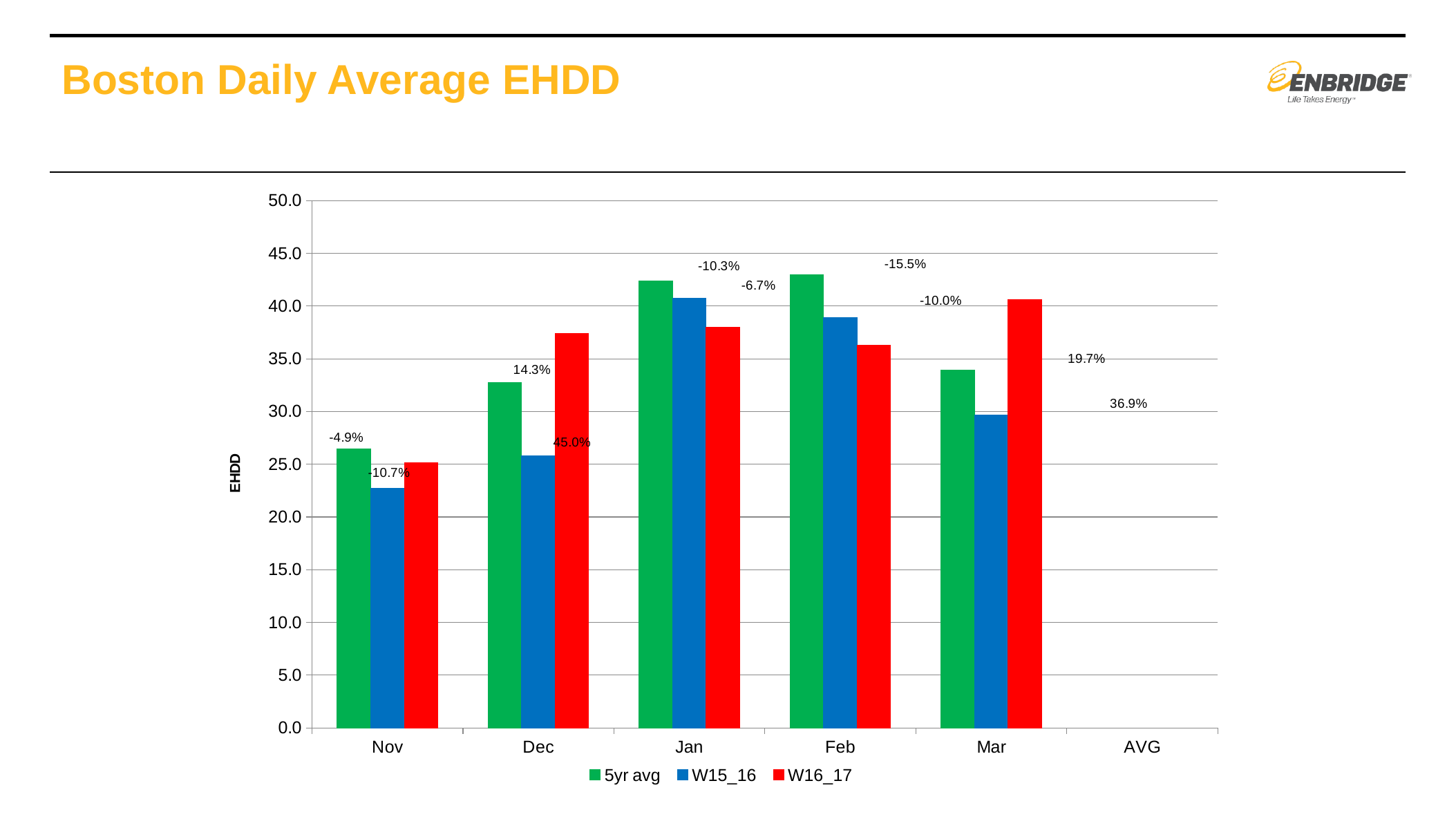
Does the 5yr avg series rise or fall from Nov to Feb? rise In Dec, which is larger: the 5yr avg bar or the W16_17 bar? W16_17 Which month has the highest W16_17 bar? Mar Which month has the lowest W15_16 bar? Nov In Jan, which is larger: the 5yr avg bar or the W16_17 bar? 5yr avg Is the 5yr avg value for Jan greater or less than 40.0? greater How many series does the legend list? 3 Which month has the lowest 5yr avg bar? Nov How many categories are labelled on the x axis? 6 What is the title of the y axis? EHDD Is the W15_16 value for Dec greater or less than 30.0? less What kind of chart is shown on the slide? bar chart